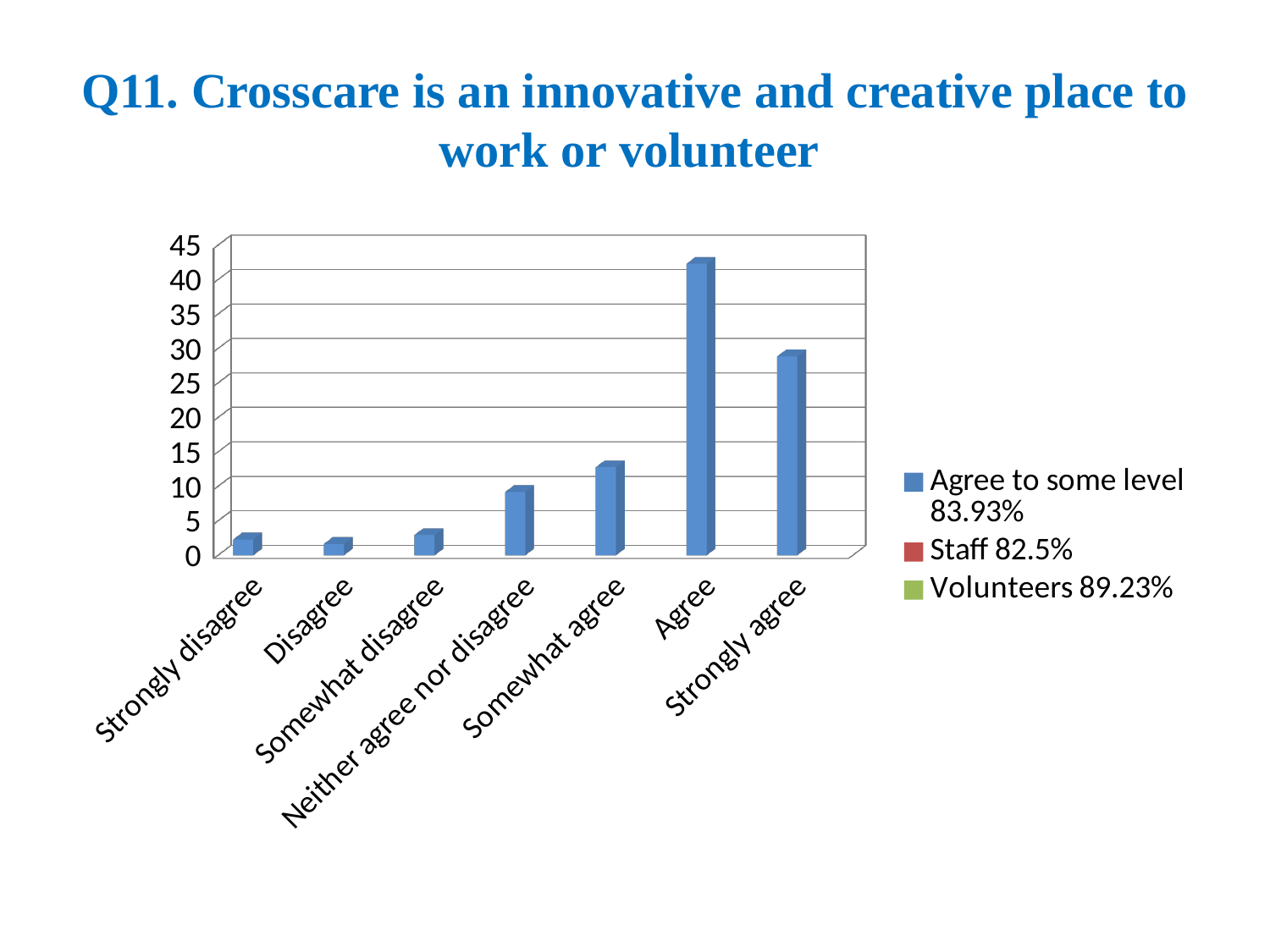
What kind of chart is shown on the slide? bar chart Is the value for Strongly disagree greater or less than 5? less Is the value for Agree greater or less than 35? greater Is the value for Neither agree nor disagree greater or less than 15? less What percentage is shown in the legend entry for Volunteers? 89.23% Which category has the highest bar in the chart? Agree Which is larger, the value for Somewhat agree or the value for Neither agree nor disagree? Somewhat agree How many categories are shown on the x axis of the chart? 7 How many entries does the chart's legend list? 3 Which is larger, the value for Agree or the value for Strongly agree? Agree